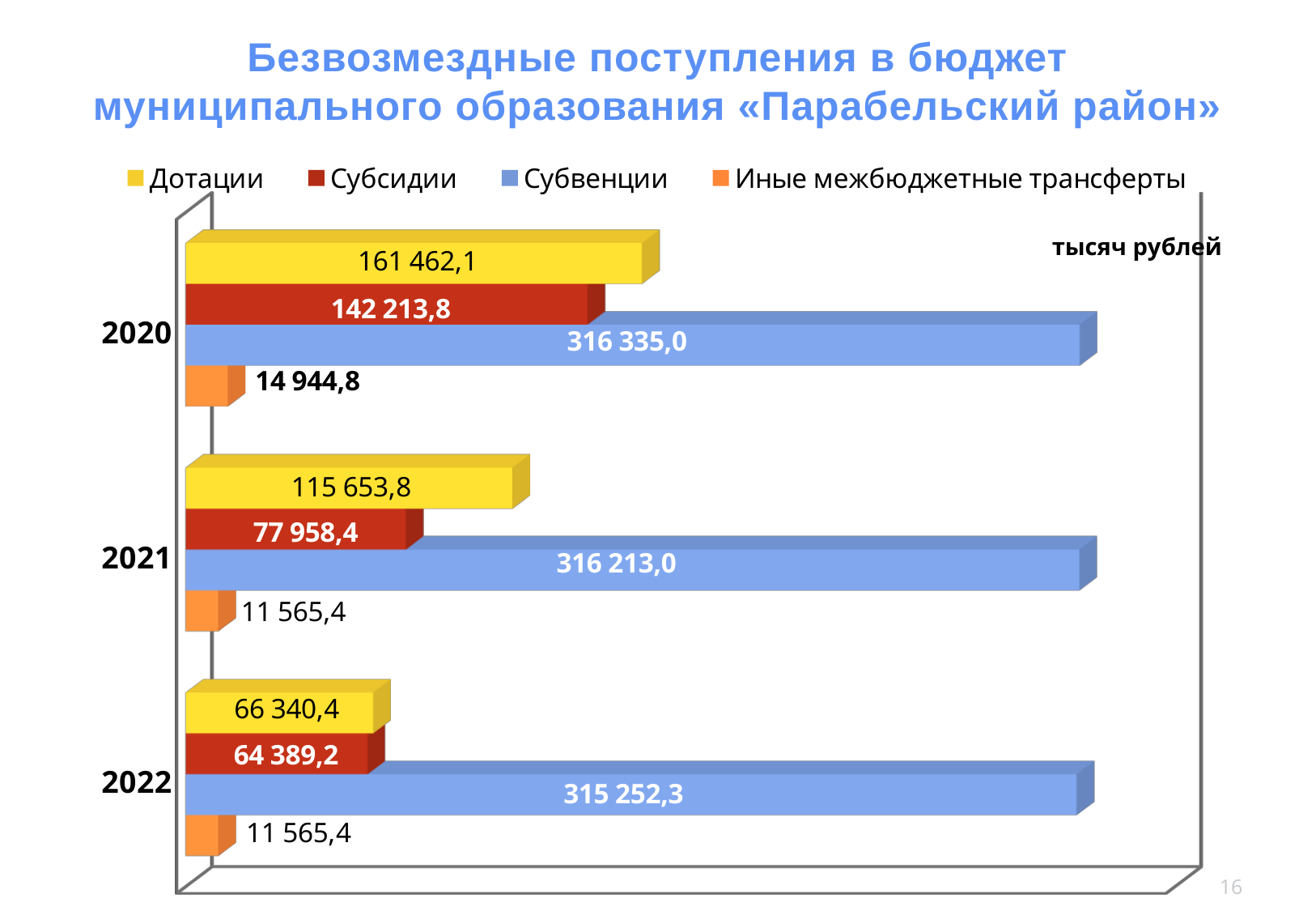
What is the value for Субвенции in 2020? 316 335,0 Which series has the highest value in 2020? Субвенции What is the value for Дотации in 2022? 66 340,4 What is the difference between Дотации and Субсидии in 2020? 19 248,3 Do the values for Дотации rise or fall from 2020 to 2022? fall Which series has the lowest value in 2020? Иные межбюджетные трансферты How many years are shown on the chart? 3 What is the value for Иные межбюджетные трансферты in 2022? 11 565,4 Which is larger: Субсидии in 2020 or Дотации in 2021? Субсидии in 2020 What is the difference between Субвенции in 2020 and Субвенции in 2022? 1 082,7 What is the value for Субсидии in 2021? 77 958,4 How many series does the legend list? 4